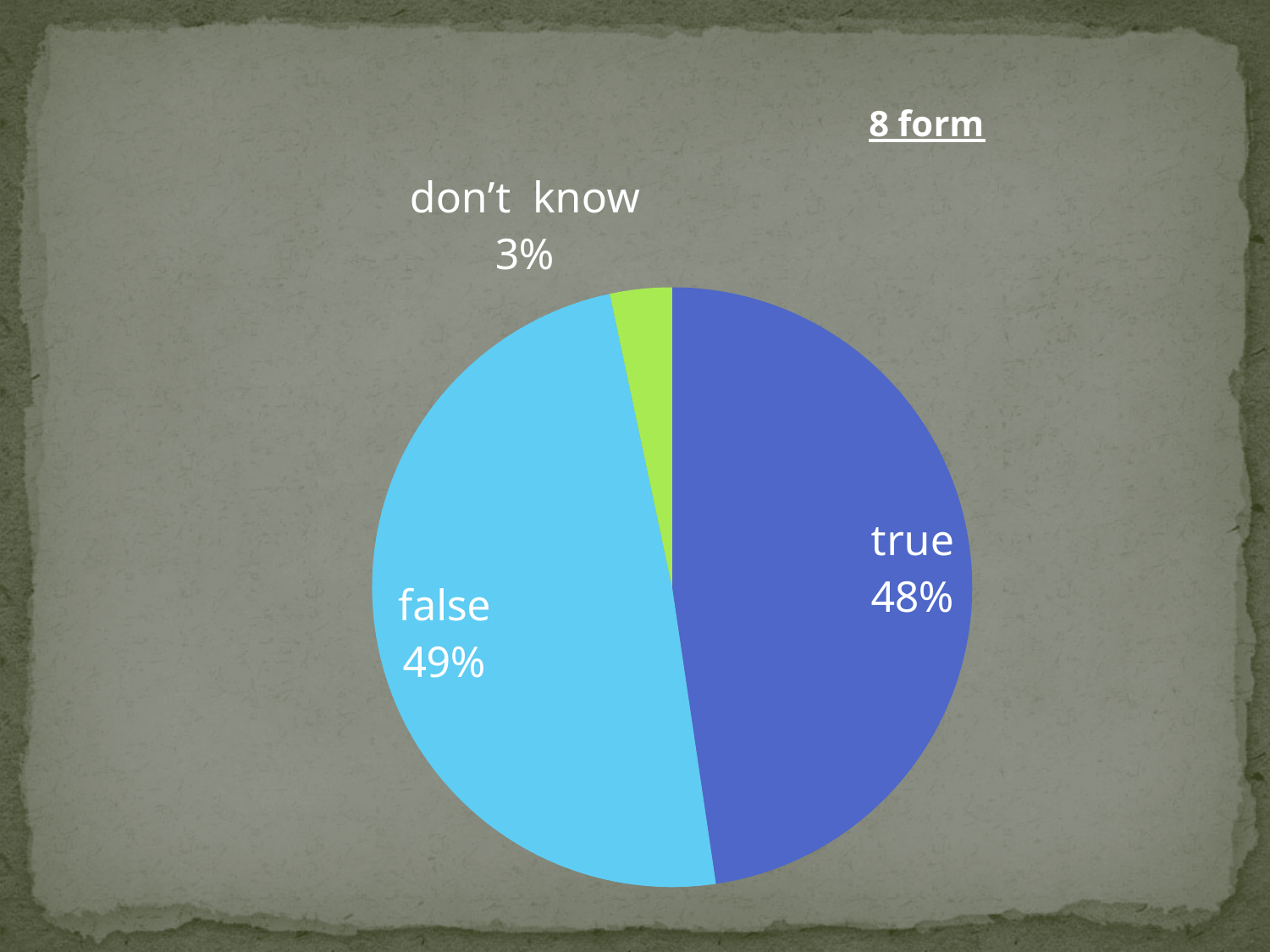
What is the combined share of the "true" and "false" slices? 97% What is the difference in percentage points between the "true" slice and the "don't know" slice? 45% What text appears in the top-right corner of the slide above the chart? 8 form What percentage of the pie is labelled "true"? 48% Which is larger, the "true" slice or the "don't know" slice? true What percentage of the pie is labelled "false"? 49% What colour is the "don't know" slice? green What kind of chart is shown on the slide? pie chart What percentage of the pie is labelled "don't know"? 3% What is the difference in percentage points between the "false" slice and the "true" slice? 1% Which slice of the pie is the smallest? don't know How many slices does the pie chart have? 3